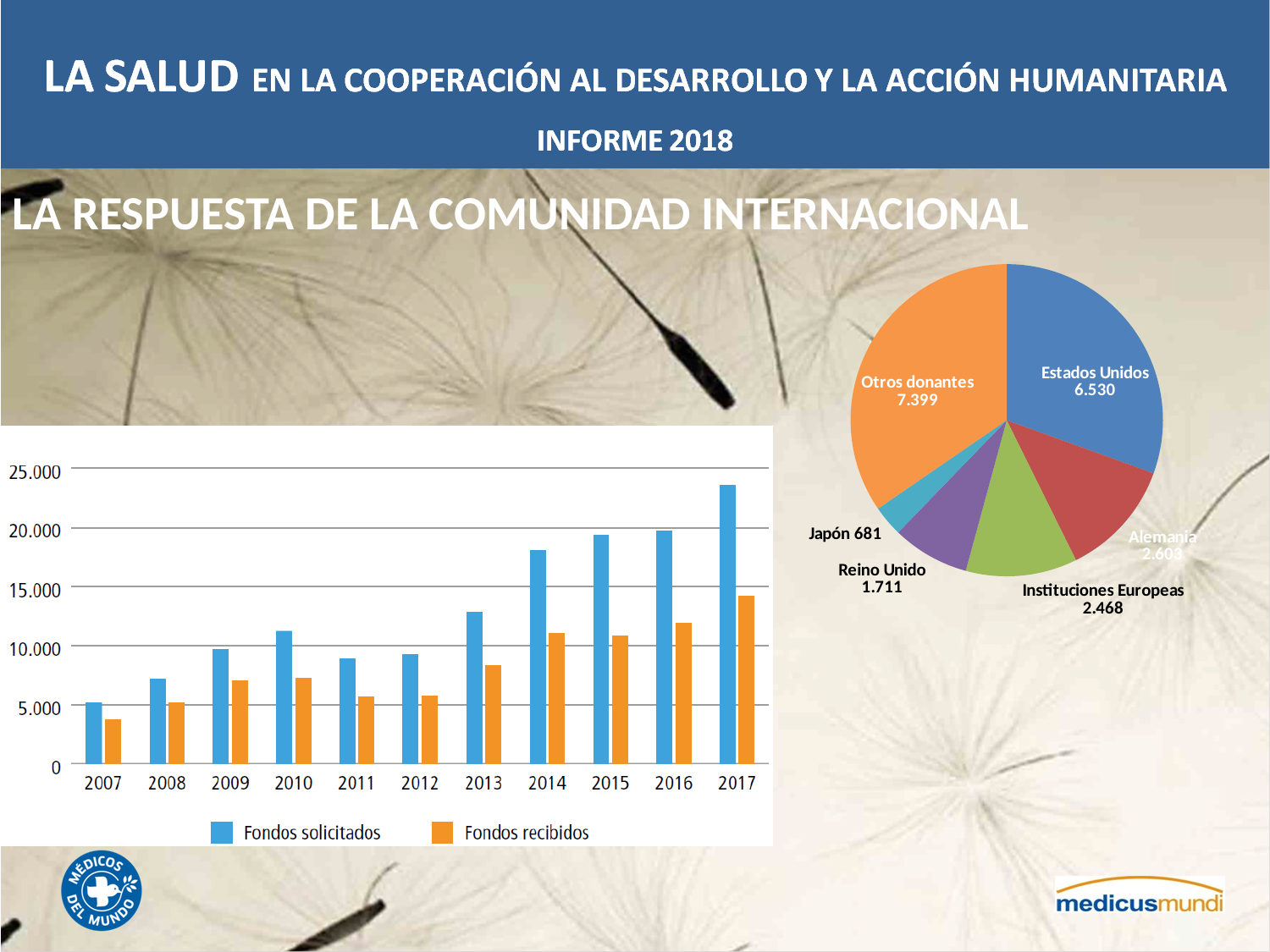
On the pie chart, how many donor categories are shown? 6 On the bar chart on the left, in which year is Fondos solicitados highest? 2017 On the pie chart, which donor has the smallest slice? Japón On the pie chart, what is the value for Reino Unido? 1.711 On the pie chart, what is the difference between the values for Estados Unidos and Alemania? 3.927 On the bar chart on the left, is the value of Fondos solicitados for 2017 greater or less than 20.000? greater On the pie chart, what is the value for Estados Unidos? 6.530 On the bar chart on the left, how many series does the legend list? 2 On the bar chart on the left, how many years are shown on the x axis? 11 On the pie chart, which is larger, Alemania or Instituciones Europeas? Alemania On the pie chart, which donor has the largest slice? Otros donantes On the bar chart on the left, is the value of Fondos recibidos for 2007 greater or less than 5.000? less